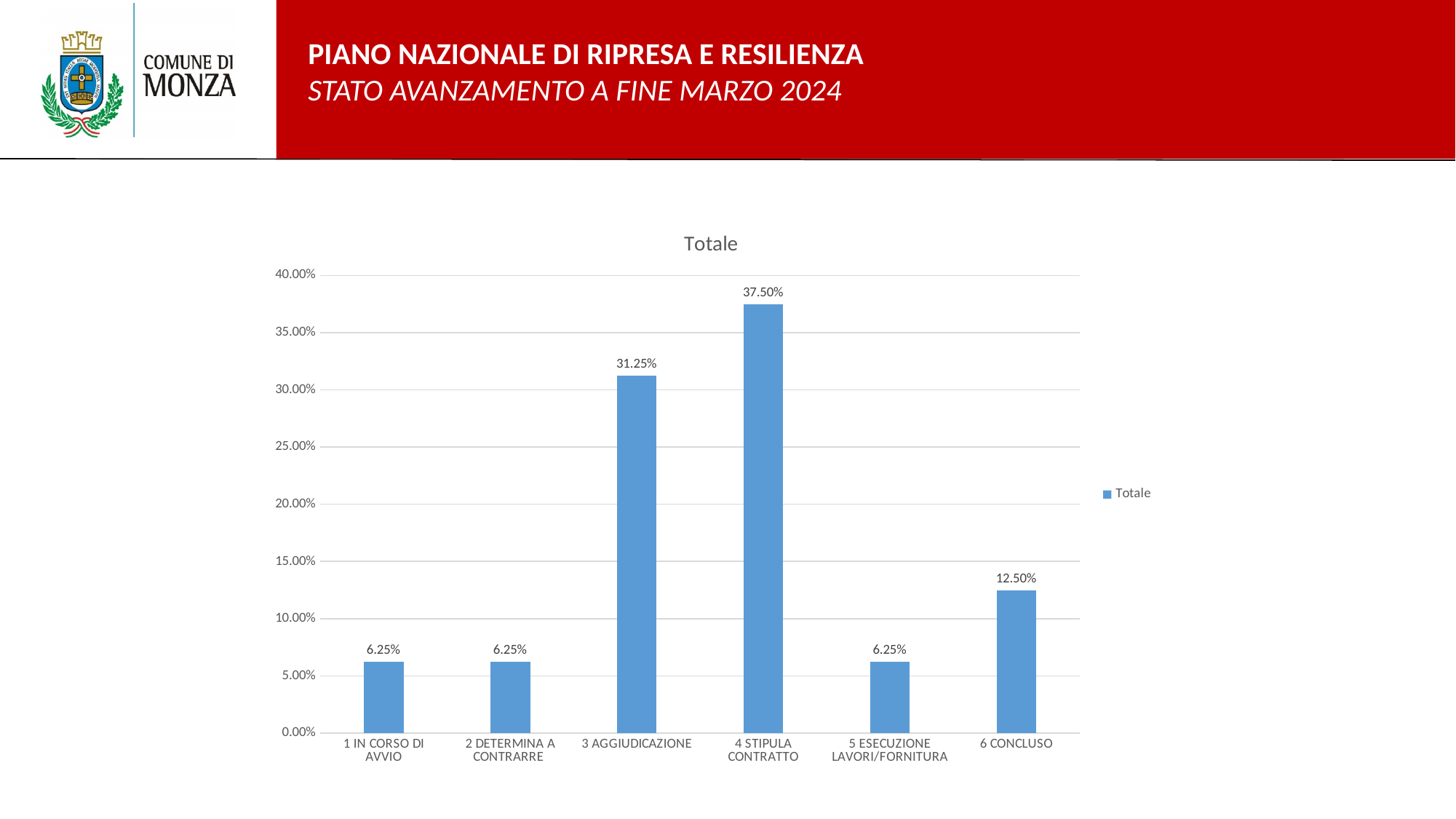
What kind of chart is shown on the slide? bar chart What is the value for 4 STIPULA CONTRATTO? 37.50% What is the difference between the values for 4 STIPULA CONTRATTO and 3 AGGIUDICAZIONE? 6.25% What is the value for 3 AGGIUDICAZIONE? 31.25% Is the value for 4 STIPULA CONTRATTO greater or less than 35.00%? greater Which category has the highest value? 4 STIPULA CONTRATTO What is the difference between the values for 6 CONCLUSO and 5 ESECUZIONE LAVORI/FORNITURA? 6.25% What is the title of the chart? Totale What is the value for 1 IN CORSO DI AVVIO? 6.25% What is the value for 6 CONCLUSO? 12.50% How many categories are shown on the x axis? 6 Which is larger, the value for 3 AGGIUDICAZIONE or the value for 6 CONCLUSO? 3 AGGIUDICAZIONE